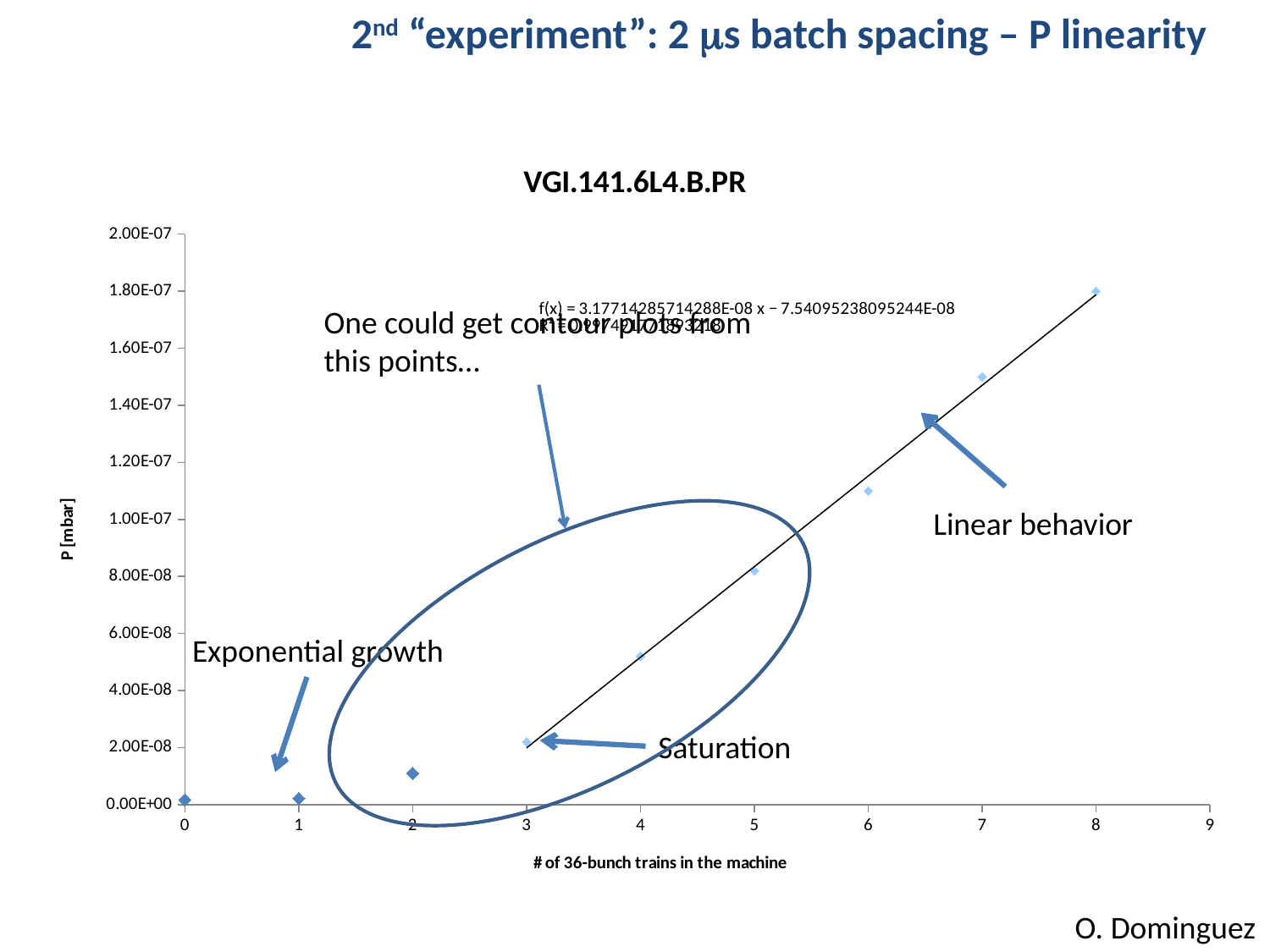
What kind of chart is shown on the slide? scatter chart Is the pressure value for 8 trains greater or less than 1.60E-07? greater How many data points are plotted on the chart? 9 What is the title of the chart? VGI.141.6L4.B.PR Which has the larger pressure value: 3 trains or 5 trains? 5 trains What is the label of the y axis? P [mbar] At which number of 36-bunch trains is the pressure highest? 8 Is the pressure value for 6 trains greater or less than 1.00E-07? greater Do the pressure values rise or fall as the number of 36-bunch trains increases? rise At which number of 36-bunch trains is the pressure lowest? 0 Is the pressure value for 2 trains greater or less than 2.00E-08? less